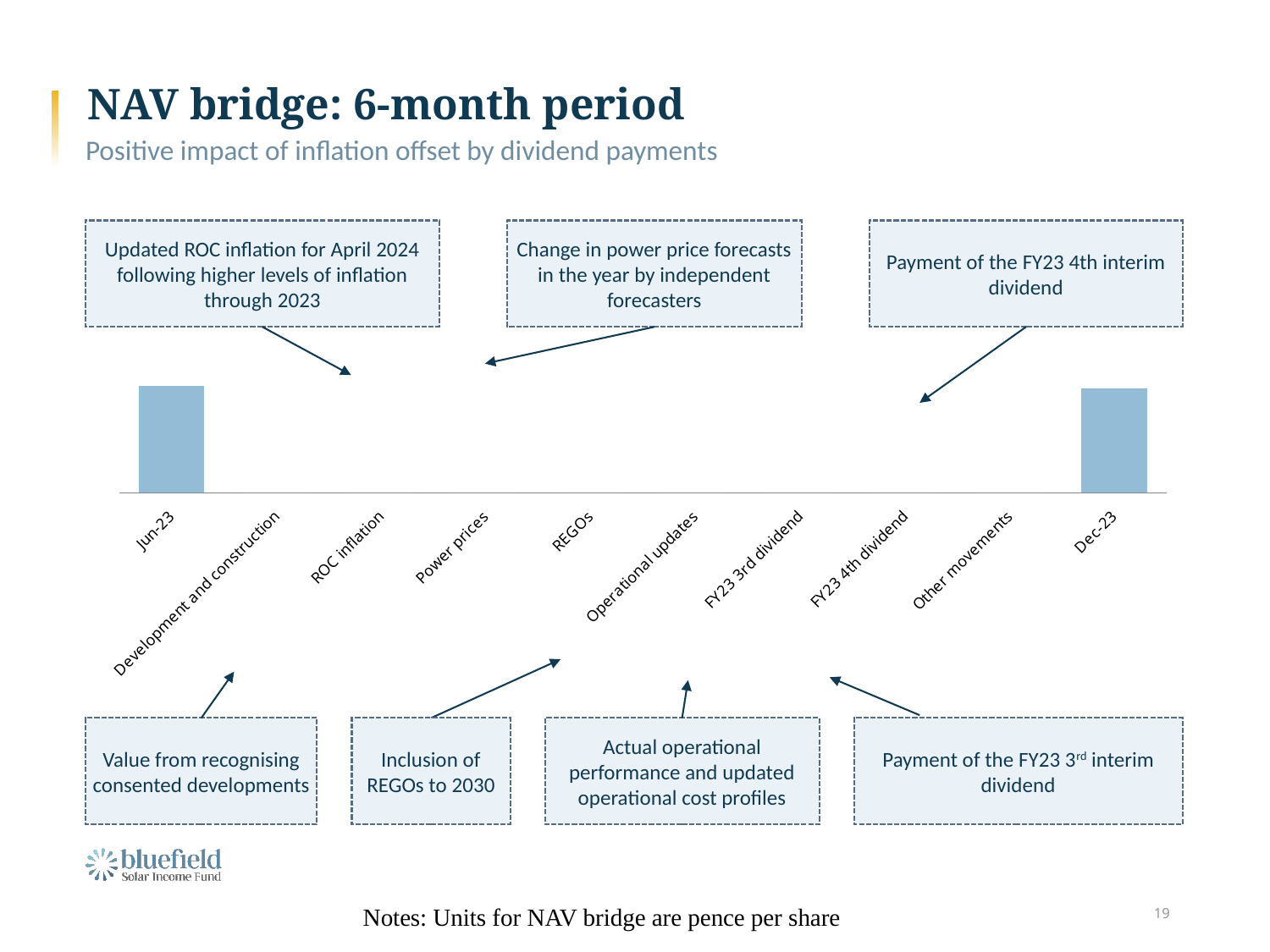
What is the title of the chart on the slide? NAV bridge: 6-month period Which category on the NAV bridge chart comes immediately before 'Dec-23'? Other movements According to the notes, what units are used for the NAV bridge? pence per share What is the last category on the x axis of the NAV bridge chart? Dec-23 How many categories are labelled along the x axis of the NAV bridge chart? 10 What kind of chart is shown on the slide? bar chart Which category on the NAV bridge chart comes immediately after 'Power prices'? REGOs What is the first category on the x axis of the NAV bridge chart? Jun-23